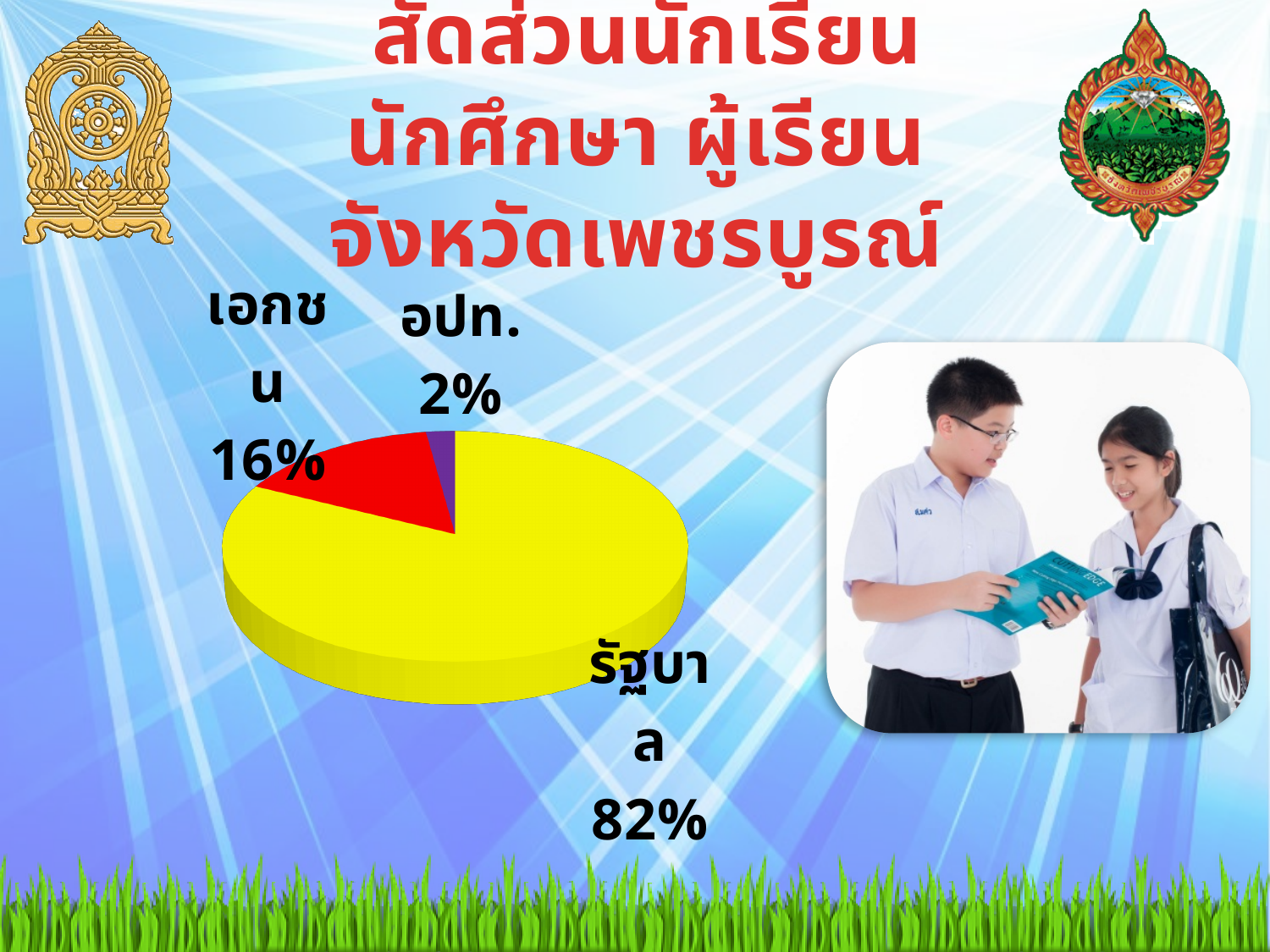
What colour is the slice for เอกชน? red Which is larger, the share for เอกชน or the share for อปท.? เอกชน What share of the pie does รัฐบาล have? 82% What kind of chart is shown on the slide? pie chart What share of the pie does เอกชน have? 16% What colour is the slice for รัฐบาล? yellow How many categories are shown in the pie chart? 3 What share of the pie does อปท. have? 2% What is the difference in percentage points between รัฐบาล and เอกชน? 66 Which category has the largest slice of the pie? รัฐบาล What is the difference in percentage points between เอกชน and อปท.? 14 Which category has the smallest slice of the pie? อปท.